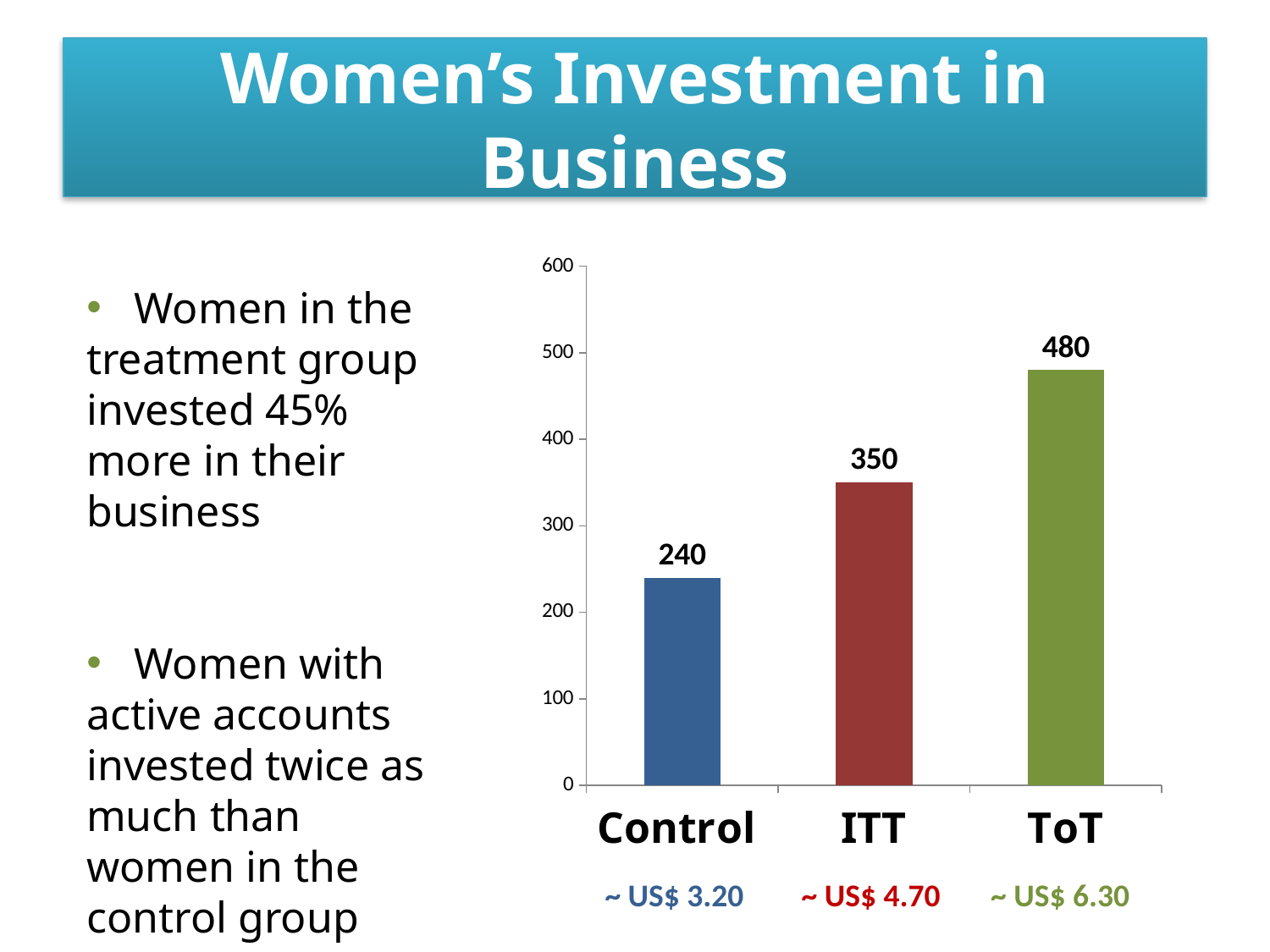
What is the value for Control? 240 What is the value for ToT? 480 What is the difference between the values for ToT and Control? 240 What is the value for ITT? 350 What is the difference between the values for ITT and Control? 110 Which is larger, the value for ITT or the value for ToT? ToT Is the value for ITT greater or less than 300? greater Which category has the highest value? ToT How many categories are shown on the x axis? 3 Which category has the lowest value? Control Do the values rise or fall from Control to ToT along the x axis? rise What kind of chart is shown on the slide? bar chart